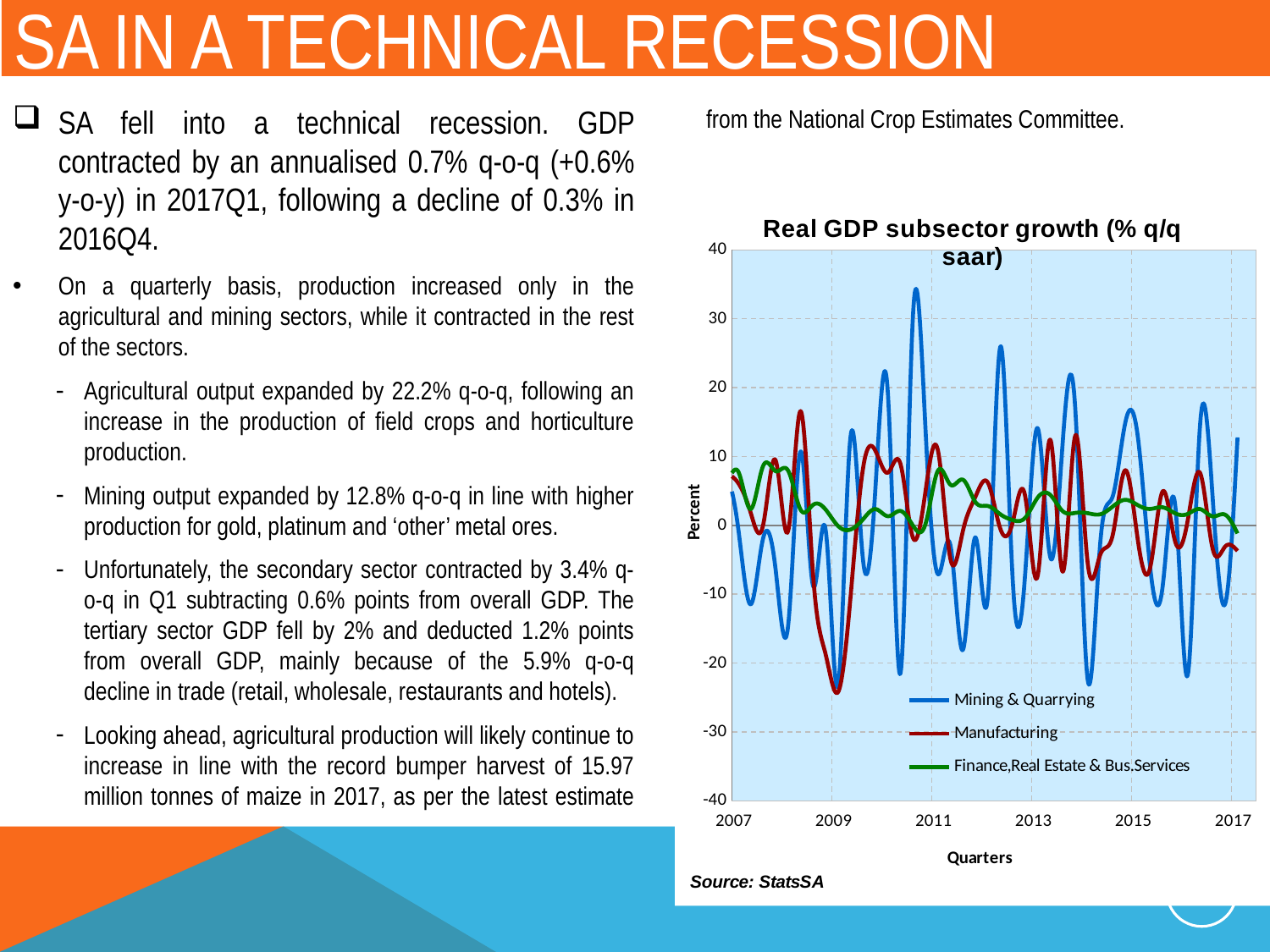
How many series does the legend of the chart list? 3 What label is shown on the vertical axis of the chart? Percent Which series has a higher peak value: Manufacturing or Finance, Real Estate & Bus. Services? Manufacturing What is the last year label on the x axis of the chart? 2017 What kind of chart is shown on the slide? Line chart Is the highest value reached by the Finance, Real Estate & Bus. Services series greater or less than 20? less Is the lowest value reached by the Manufacturing series greater or less than -20? less What is the first year label on the x axis of the chart? 2007 Is the highest value reached by the Mining & Quarrying series greater or less than 30? greater How many year labels are shown along the x axis of the chart? 6 What is the title of the chart? Real GDP subsector growth (% q/q saar) Which series reaches the highest peak value on the chart? Mining & Quarrying